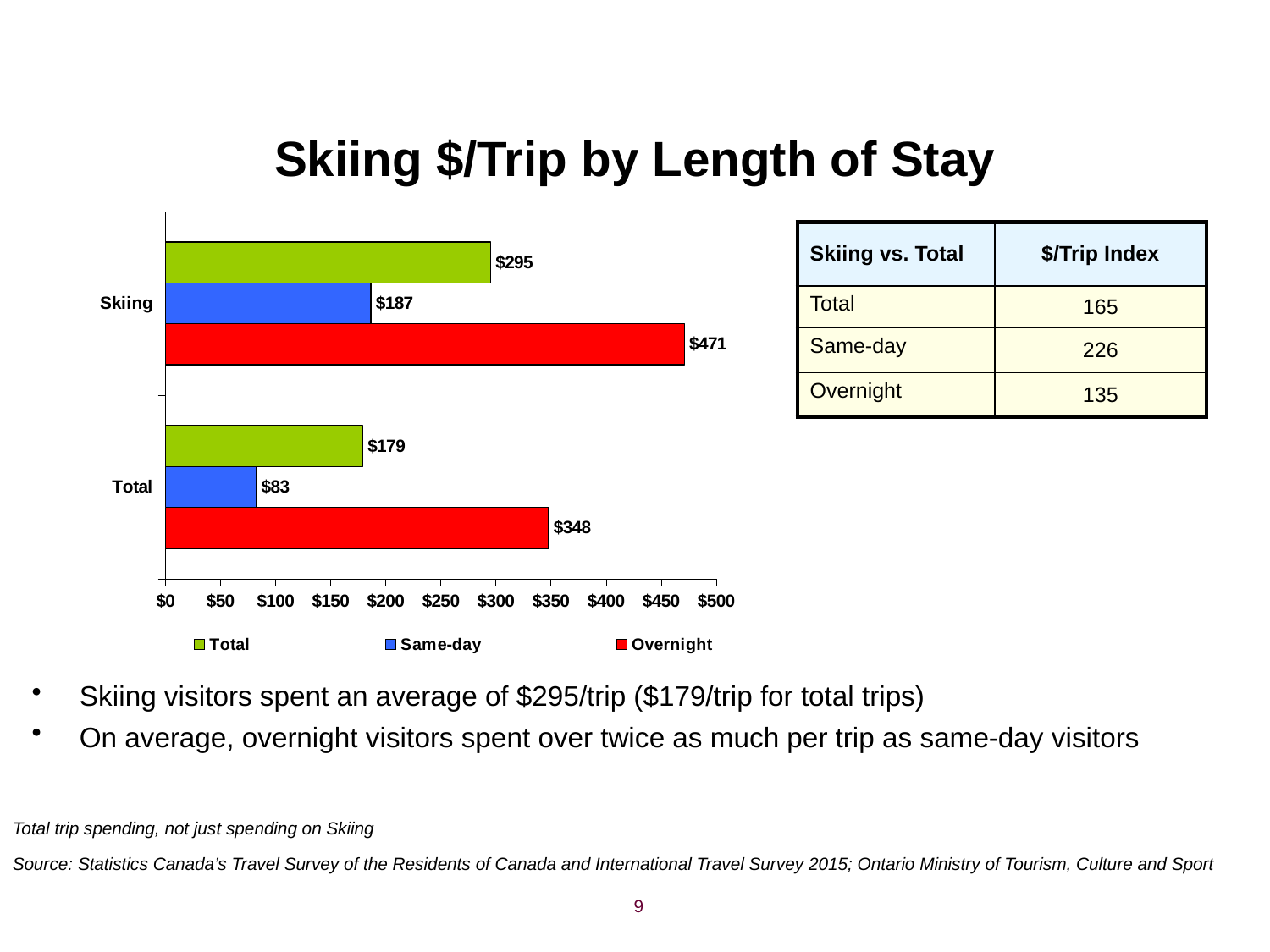
What is the Overnight value for Skiing? $471 What is the Total series value for the Skiing category? $295 Which series has the highest value in the Skiing category? Overnight How many categories are shown on the chart? 2 What is the difference between the Same-day values for Skiing and Total? $104 What is the difference between the Overnight values for Skiing and Total? $123 What is the Overnight value for the Total category? $348 What is the Same-day value for Total? $83 What kind of chart is shown on the slide? Bar chart How many series does the legend list? 3 Which series has the lowest value in the Total category? Same-day Which is larger: the Same-day value for Skiing or the Total series value for Total? Same-day value for Skiing